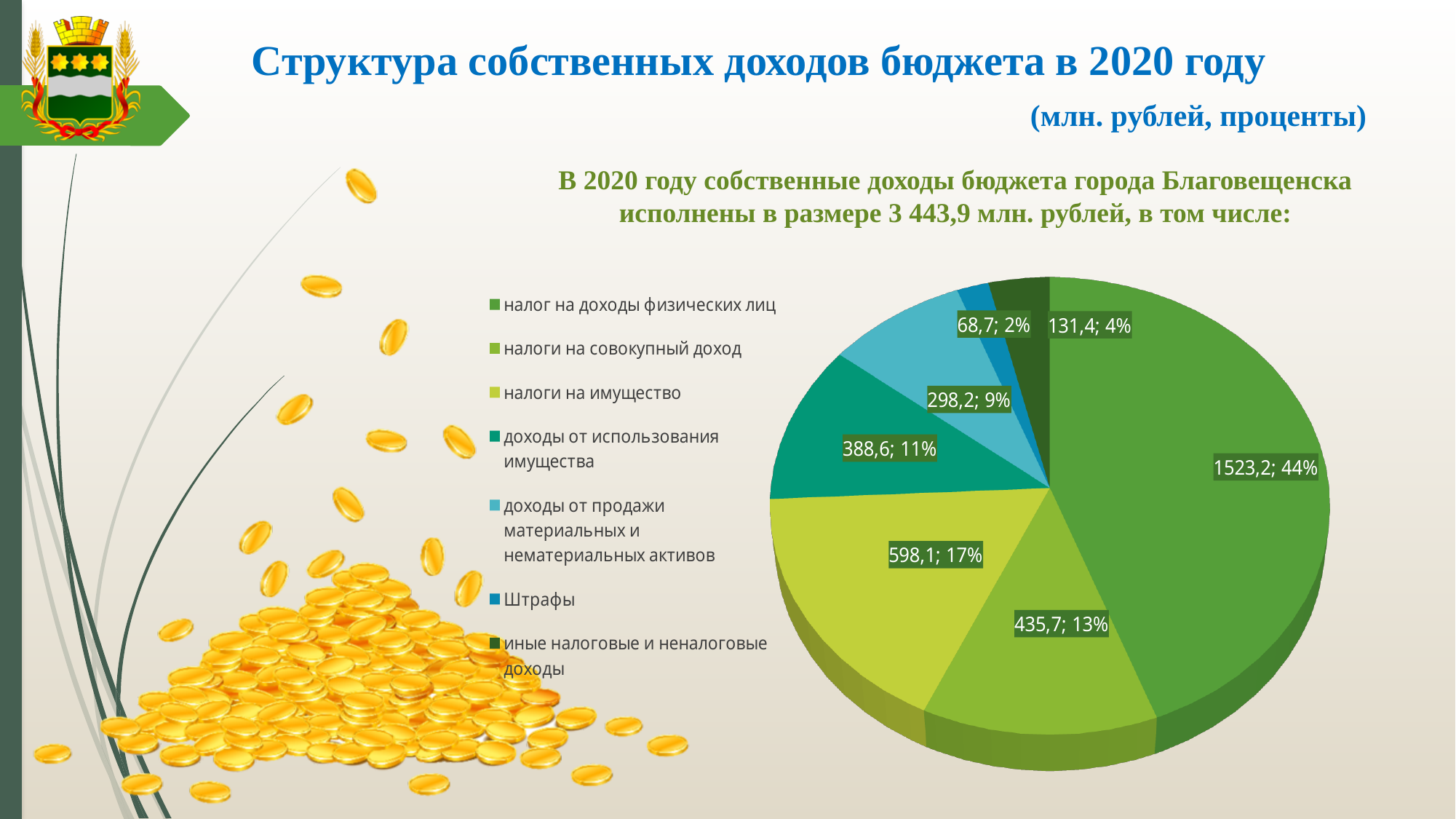
Which is larger: налоги на имущество or налоги на совокупный доход? налоги на имущество What value is shown for Штрафы? 68,7; 2% What kind of chart is shown on the slide? pie chart How many slices does the pie chart have? 7 Which category has the largest slice of the pie? налог на доходы физических лиц What value is shown for доходы от использования имущества? 388,6; 11% What value is shown for налог на доходы физических лиц? 1523,2; 44% What share of the pie does иные налоговые и неналоговые доходы represent? 4% What share of the pie does налоги на имущество represent? 17% What is the title of the slide containing the pie chart? Структура собственных доходов бюджета в 2020 году Which category has the smallest slice of the pie? Штрафы What is the difference between the values for налоги на имущество and налоги на совокупный доход? 162,4